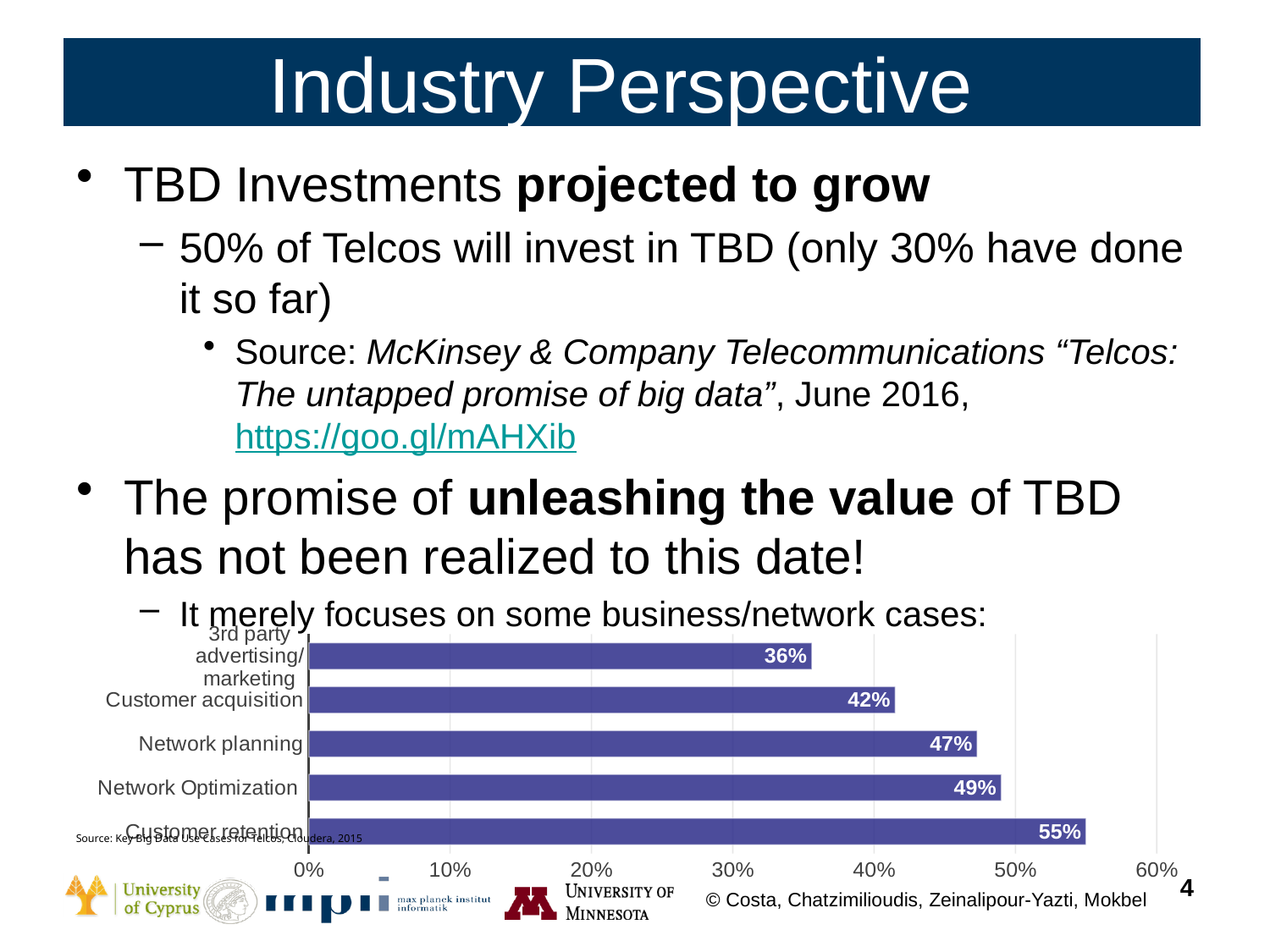
How many categories are shown in the chart? 5 What is the value for Network planning? 47% Is the value for Network Optimization greater or less than 40%? greater What is the value for Customer acquisition? 42% What is the difference between the values for Network planning and Customer acquisition? 5% What is the value for Customer retention? 55% Which is larger, the value for Network Optimization or the value for Customer acquisition? Network Optimization What is the difference between the values for Customer retention and Network Optimization? 6% What kind of chart is shown on the slide? bar chart Which category has the highest value? Customer retention What is the value for 3rd party advertising/marketing? 36% Which category has the lowest value? 3rd party advertising/marketing